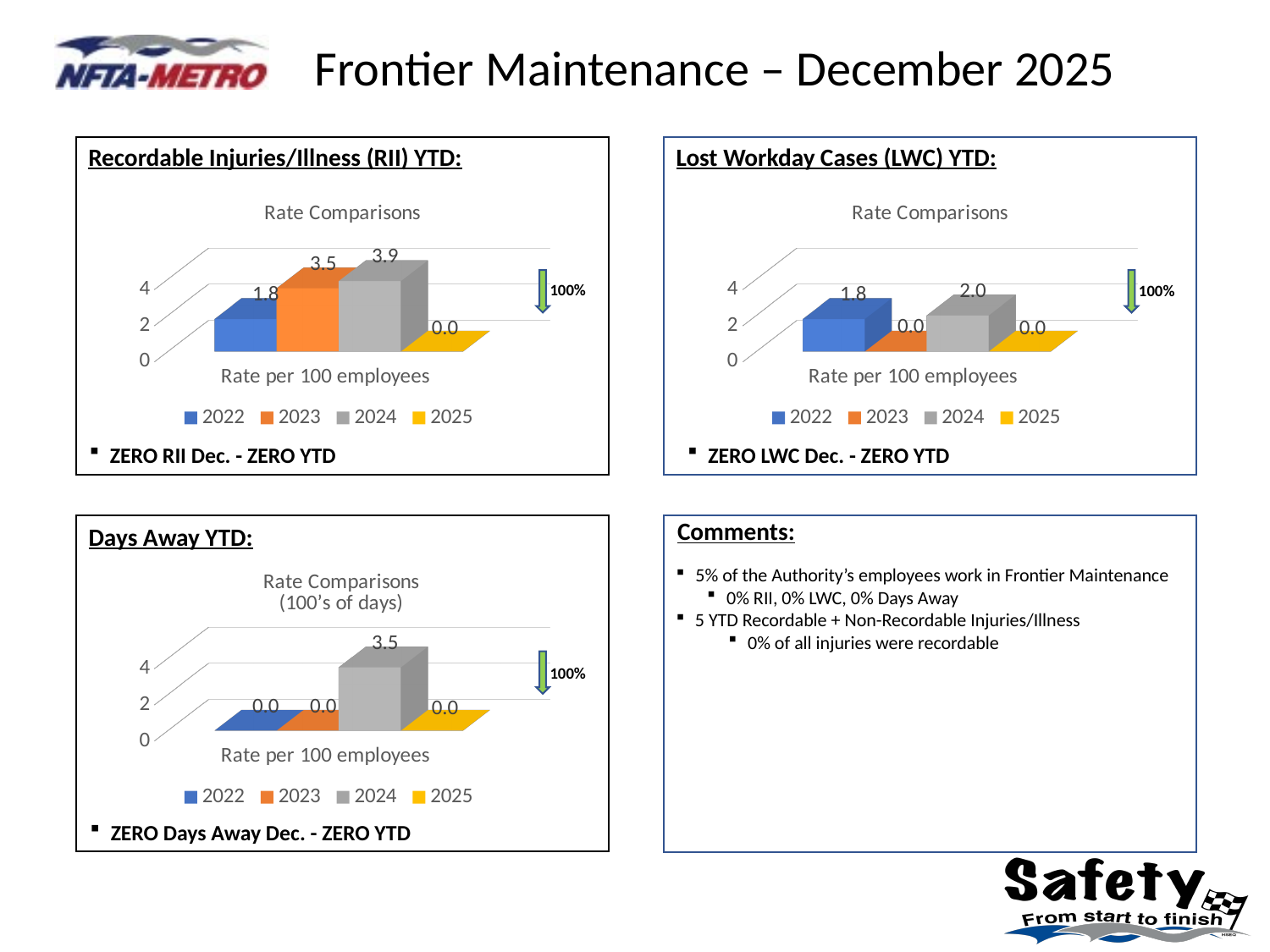
In the Days Away YTD chart, what is the difference between the 2024 and 2025 values? 3.5 What is the x-axis label of the Lost Workday Cases (LWC) YTD chart? Rate per 100 employees In the Lost Workday Cases (LWC) YTD chart, which is larger, the value for 2022 or the value for 2024? 2024 In the Recordable Injuries/Illness (RII) YTD chart, what is the difference between the 2023 and 2022 values? 1.7 In the Recordable Injuries/Illness (RII) YTD chart, which year has the highest value? 2024 In the Lost Workday Cases (LWC) YTD chart, what is the value for 2024? 2.0 In the Recordable Injuries/Illness (RII) YTD chart, what is the value for 2024? 3.9 In the Days Away YTD chart, which year has the highest value? 2024 In the Days Away YTD chart, what is the value for 2024? 3.5 In the Lost Workday Cases (LWC) YTD chart, what is the value for 2023? 0.0 In the Recordable Injuries/Illness (RII) YTD chart, how many series does the legend list? 4 What kind of chart is used in the Days Away YTD box? Bar chart